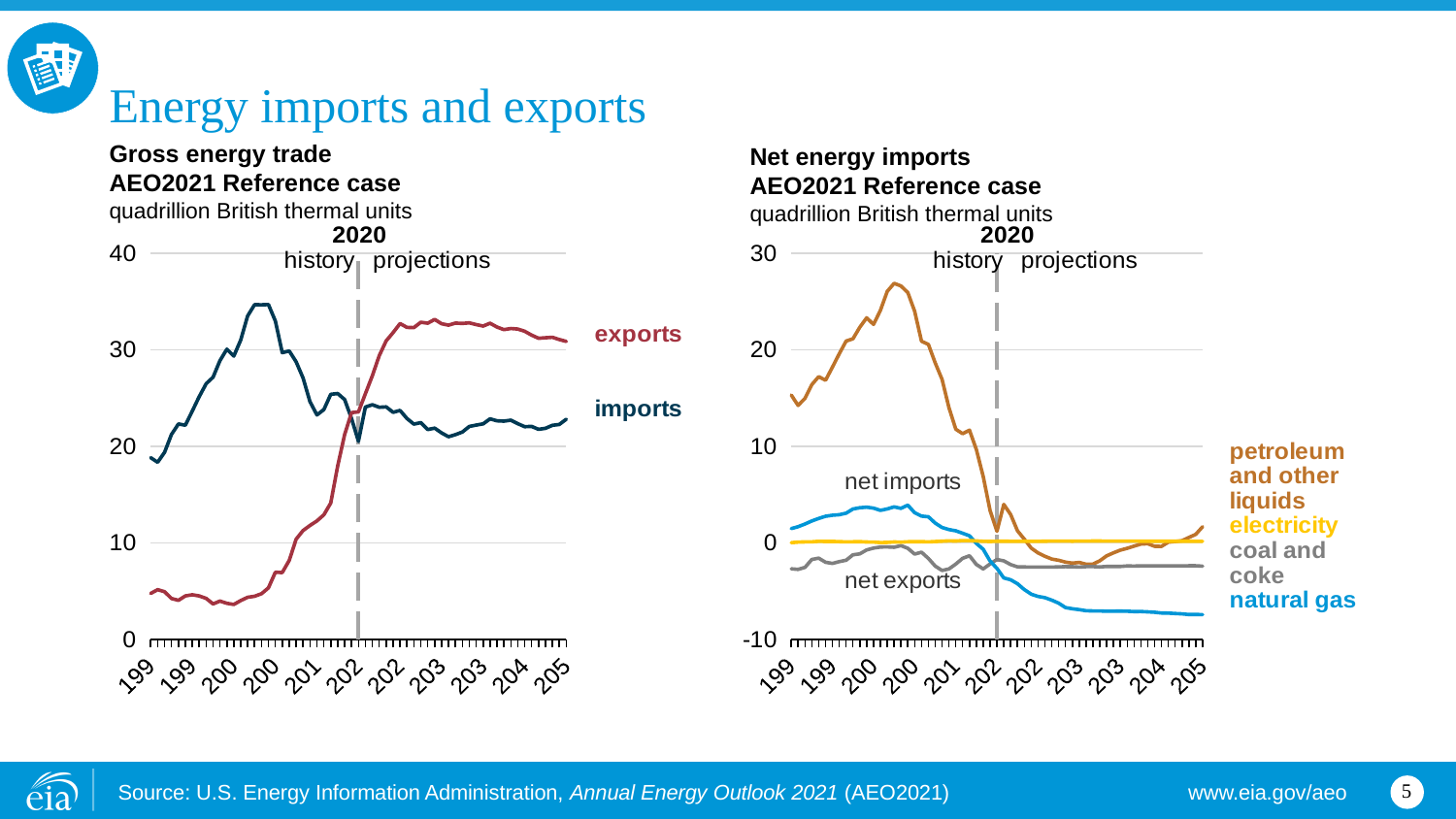
What type of chart is the 'Gross energy trade' chart on the left? line chart On the 'Gross energy trade' chart, which series is higher at the end of the projection period, exports or imports? exports What unit is used on the y axis of both charts? quadrillion British thermal units How many series are shown on the 'Net energy imports' chart on the right? 4 On the 'Gross energy trade' chart, is the value for exports at the start of the history period greater or less than 10? less On the 'Gross energy trade' chart, is the value for imports at the end of the projection period greater or less than 30? less On the 'Gross energy trade' chart, do exports generally rise or fall over the history period up to 2020? rise On the 'Net energy imports' chart, does natural gas rise or fall over the projection period after 2020? fall On the 'Net energy imports' chart, is the peak value for petroleum and other liquids greater or less than 20? greater How many series are shown on the 'Gross energy trade' chart on the left? 2